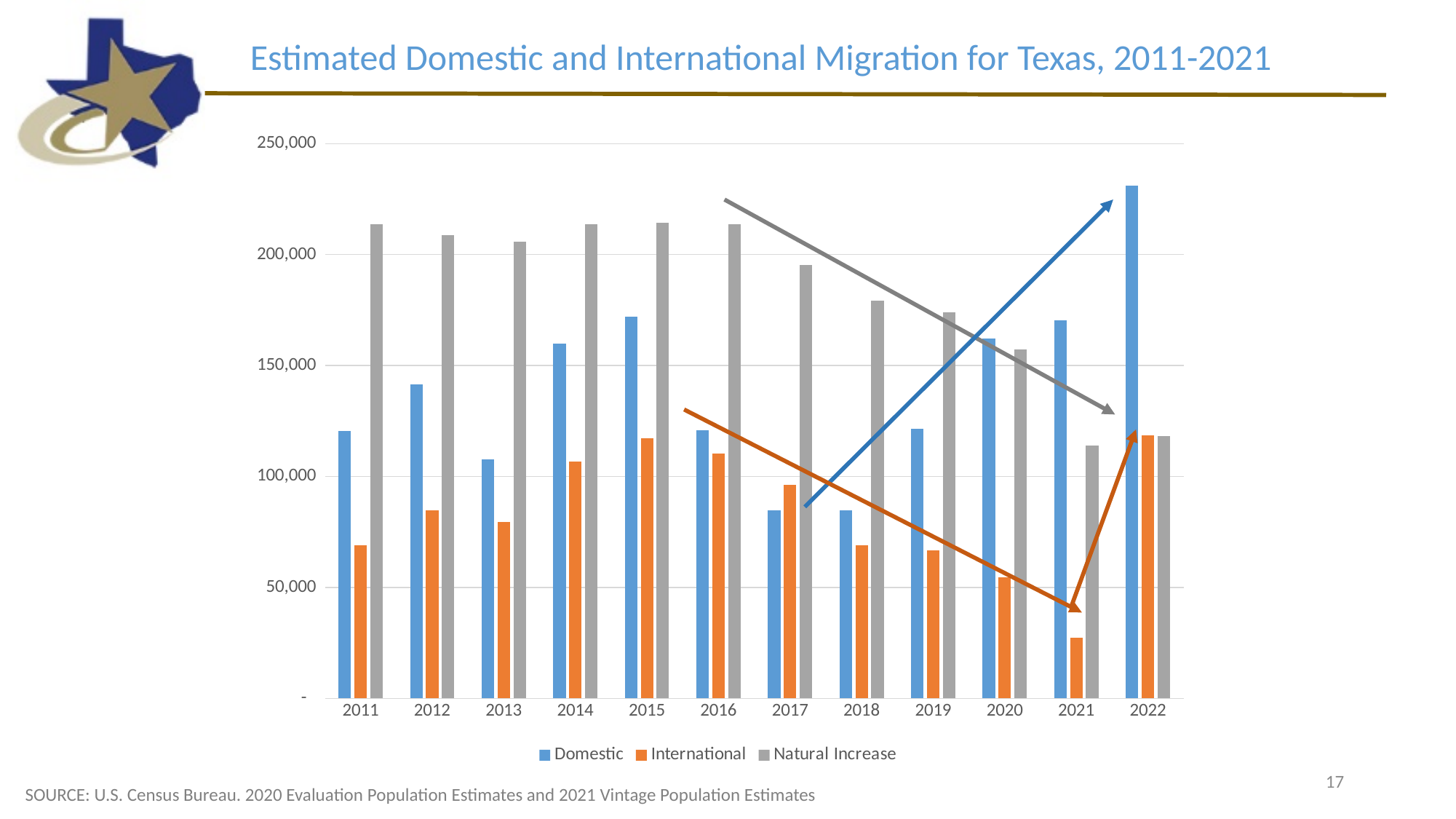
How many series does the legend list? 3 Does the Natural Increase series generally rise or fall from 2011 to 2021? Fall How many years are shown on the x axis? 12 Which colour represents the International series in the legend? Orange What kind of chart is shown on the slide? Bar chart Is the Natural Increase value for 2011 greater or less than 200,000? greater In 2015, which is larger: Domestic or International? Domestic Is the Domestic value for 2017 greater or less than 100,000? less Is the International value for 2021 greater or less than 50,000? less In which year is the Domestic value highest? 2022 In which year is the International value lowest? 2021